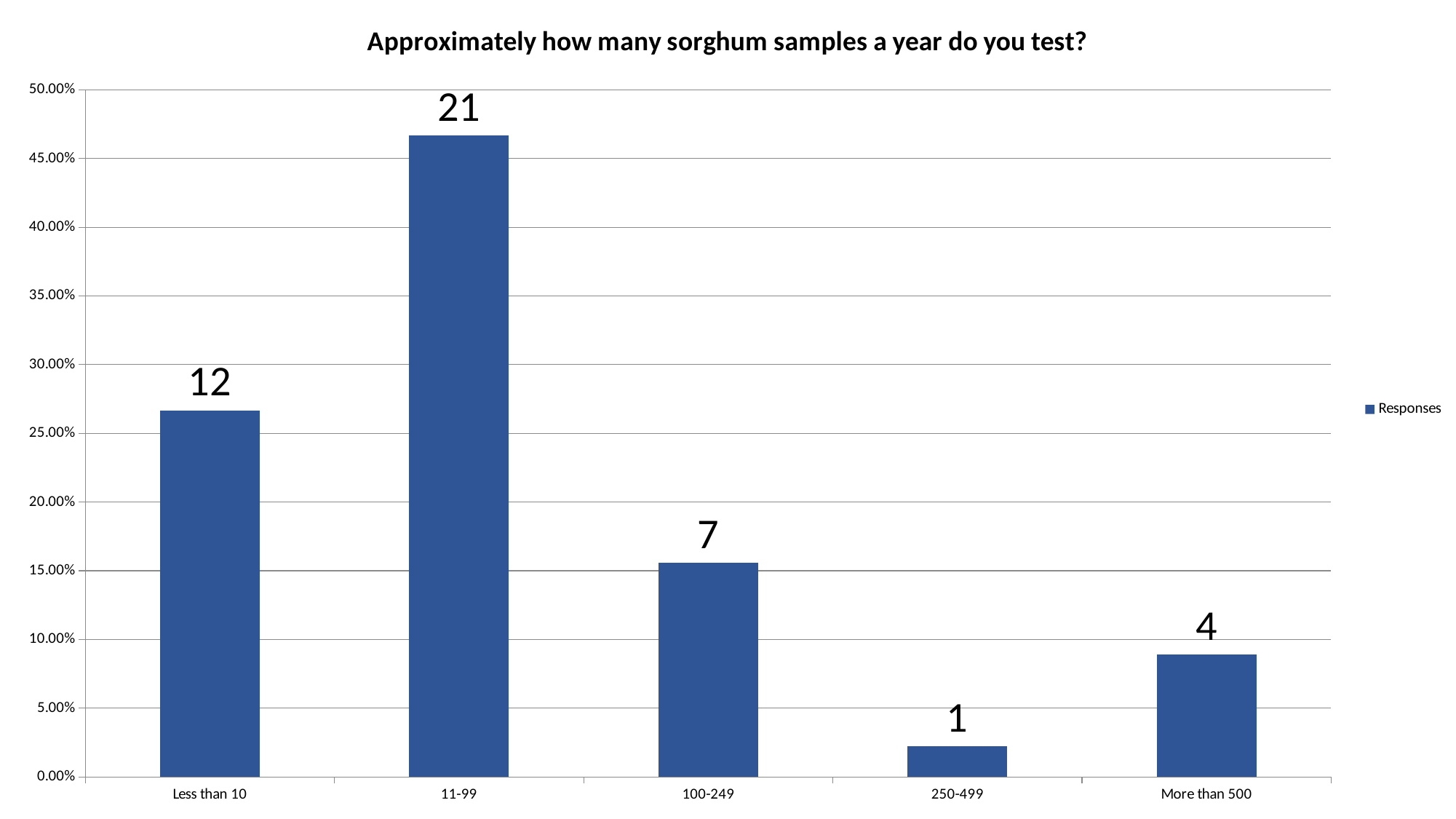
Is the value for '11-99' greater or less than 45.00%? greater What is the data label shown on the bar for 'More than 500'? 4 Is the value for 'More than 500' greater or less than 10.00%? less What is the data label shown on the bar for 'Less than 10'? 12 How many categories are shown on the x axis? 5 What is the data label shown on the bar for '250-499'? 1 What is the difference between the data labels for '11-99' and '100-249'? 14 What is the data label shown on the bar for '11-99'? 21 Which category has the highest bar? 11-99 Which is larger, the bar for 'Less than 10' or the bar for '100-249'? Less than 10 Which category has the lowest bar? 250-499 What kind of chart is this? bar chart